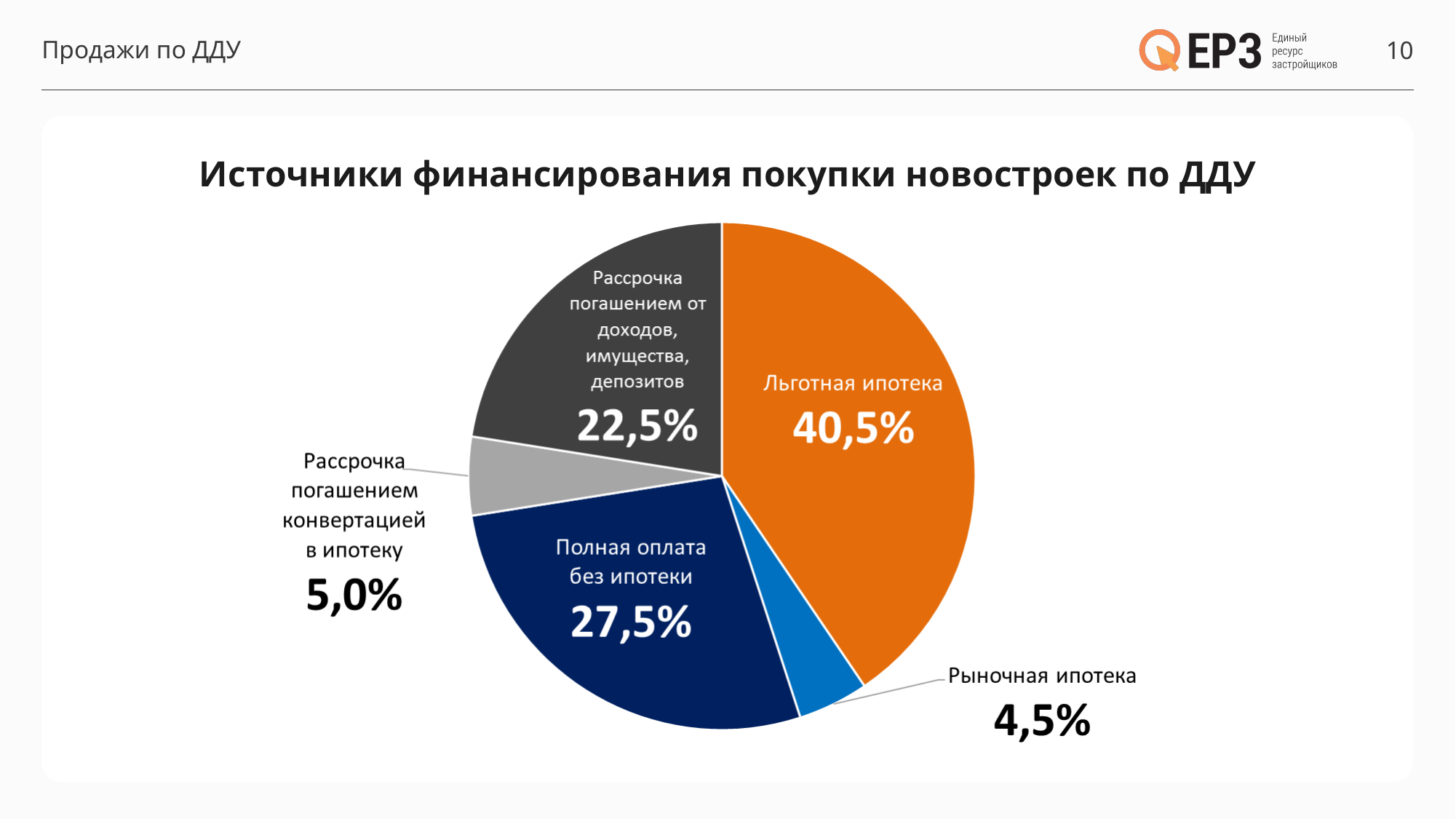
What is the value for Рассрочка погашением конвертацией в ипотеку? 5,0% What is the value for Рассрочка погашением от доходов, имущества, депозитов? 22,5% Which category has the largest share of the pie? Льготная ипотека What is the difference between the shares of Льготная ипотека and Полная оплата без ипотеки? 13 percentage points Which category has the smallest share of the pie? Рыночная ипотека What kind of chart is shown on the slide? Pie chart What is the title of the chart? Источники финансирования покупки новостроек по ДДУ What share of the pie does Льготная ипотека have? 40,5% What is the value for Полная оплата без ипотеки? 27,5% What is the value for Рыночная ипотека? 4,5% How many categories are shown in the pie chart? 5 Which is larger: Рассрочка погашением от доходов, имущества, депозитов or Полная оплата без ипотеки? Полная оплата без ипотеки